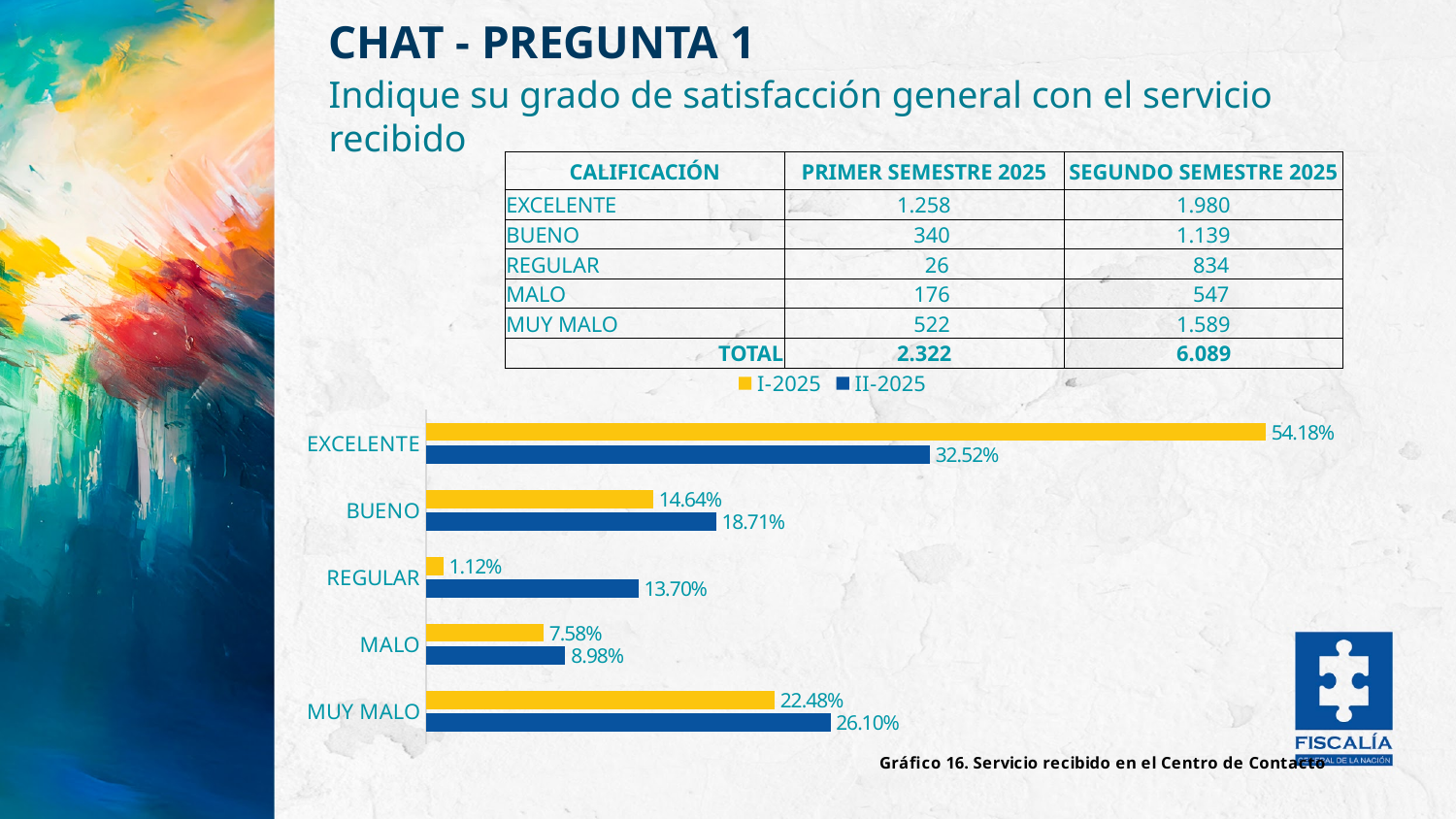
What is the value for REGULAR in the II-2025 series? 13.70% What is the value for EXCELENTE in the I-2025 series? 54.18% What is the value for MUY MALO in the I-2025 series? 22.48% How many categories are shown on the chart? 5 Which colour represents the II-2025 series in the chart? Blue What is the difference between the I-2025 and II-2025 values for EXCELENTE? 21.66% How many series does the legend list? 2 What kind of chart is shown on the slide? Bar chart Which is larger for MALO: the I-2025 value or the II-2025 value? II-2025 What is the difference between the II-2025 and I-2025 values for BUENO? 4.07% Which category has the highest value in the II-2025 series? EXCELENTE Which category has the lowest value in the I-2025 series? REGULAR